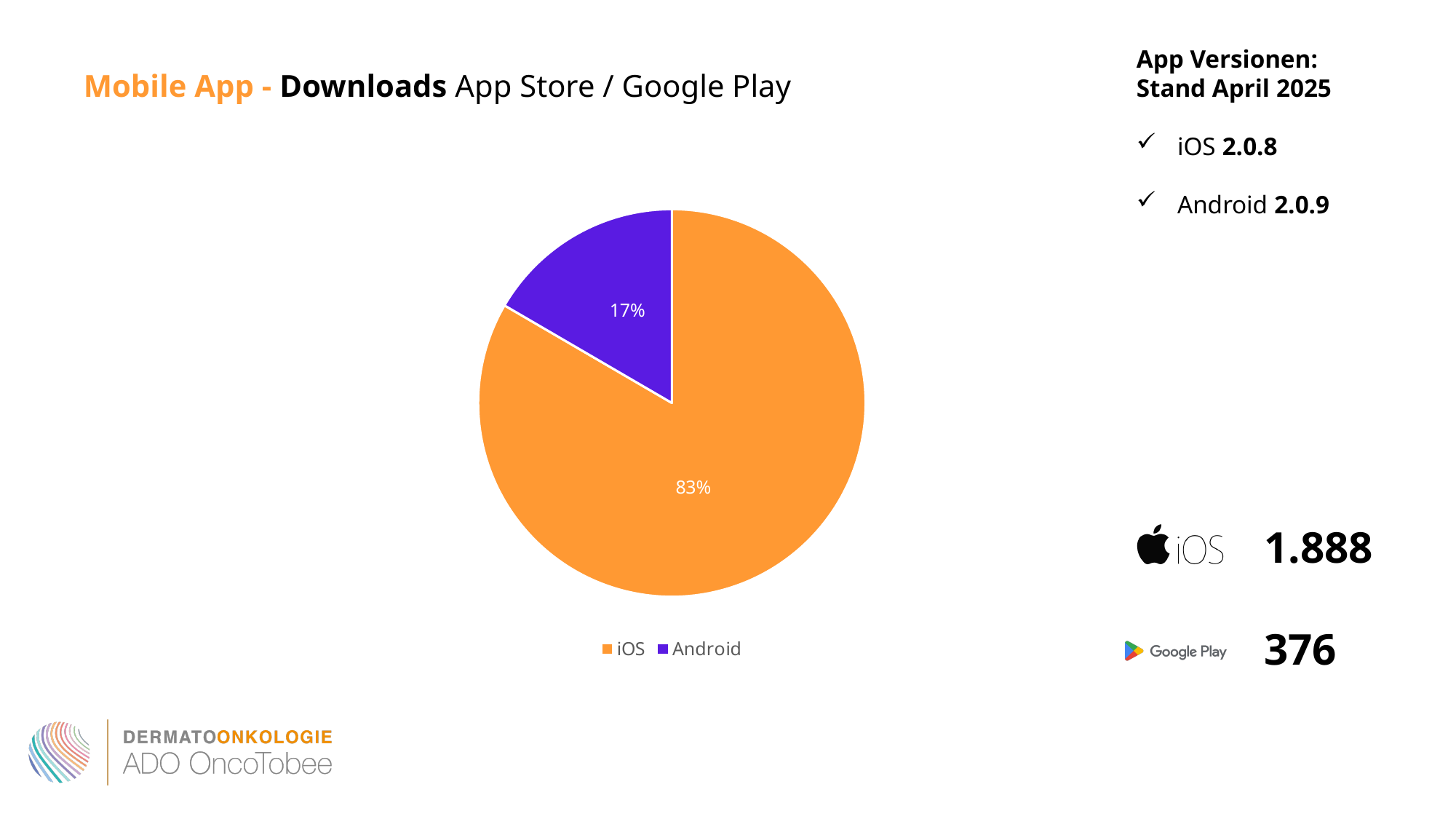
How many slices does the pie chart have? 2 What colour is the iOS slice in the pie chart? orange What share of the pie does Android account for? 17% Which is larger, the iOS slice or the Android slice? iOS What colour is the Android slice in the pie chart? purple Which slice of the pie is the smallest? Android What is the difference in percentage points between the iOS and Android slices? 66 Which slice of the pie is the largest? iOS How many entries does the legend list? 2 What share of the pie does iOS account for? 83% What type of chart is shown on the slide? pie chart